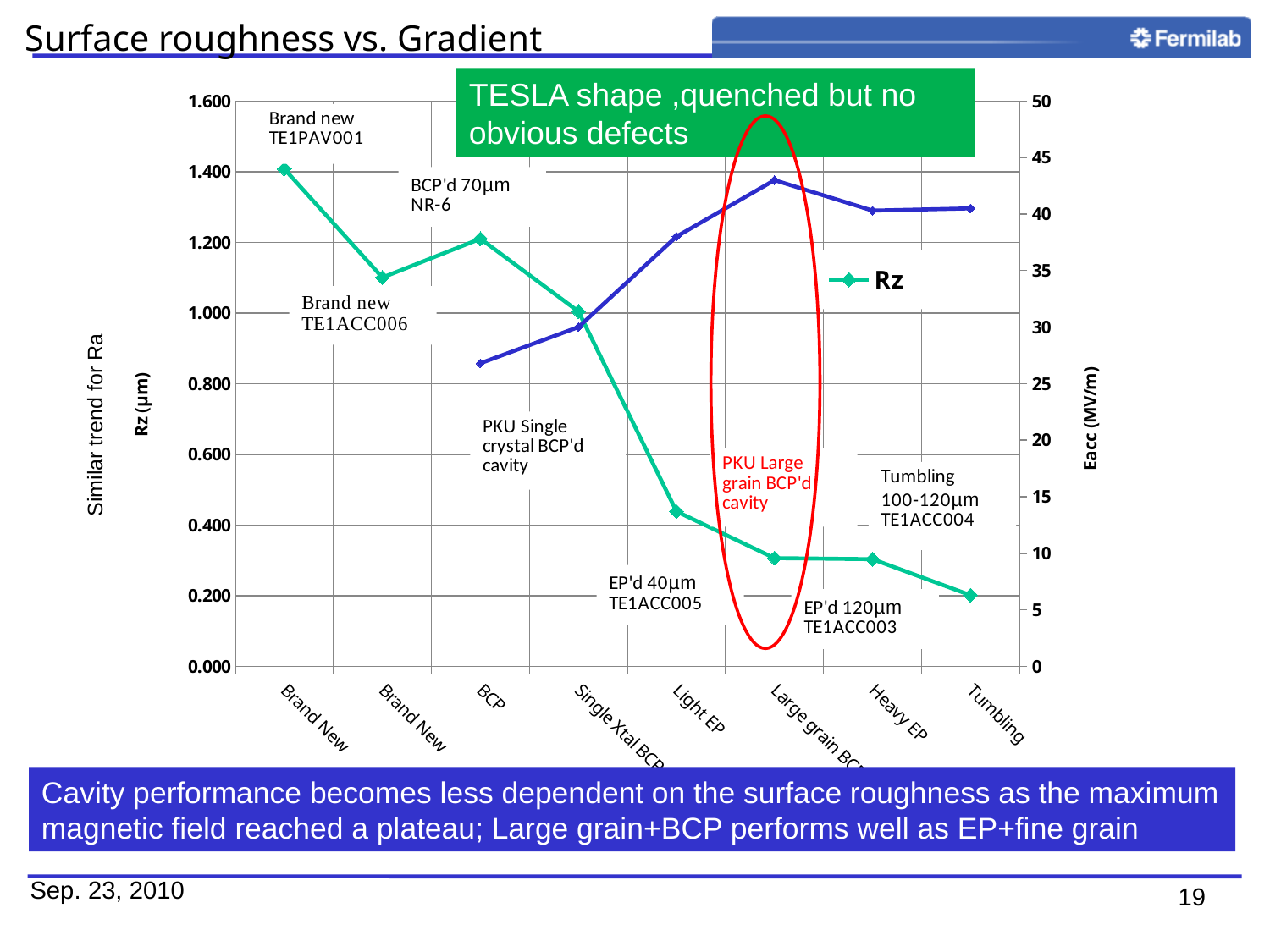
Does the Rz line generally rise or fall from left to right across the categories? fall Which has the larger Rz value, Single Xtal BCP or Light EP? Single Xtal BCP What kind of chart is shown on the slide? line chart Which category has the highest Rz value? Brand New (first) Is the Rz value for Light EP greater or less than 0.600? less Is the Eacc value for BCP greater or less than 30? less Which category has the highest Eacc value on the blue line? Large grain BCP How many series does the chart's legend list? 1 Which category has the lowest Rz value? Tumbling Is the Eacc value for Large grain BCP greater or less than 40? greater How many categories are shown along the x axis of the chart? 8 What is the label of the right-hand vertical axis? Eacc (MV/m)